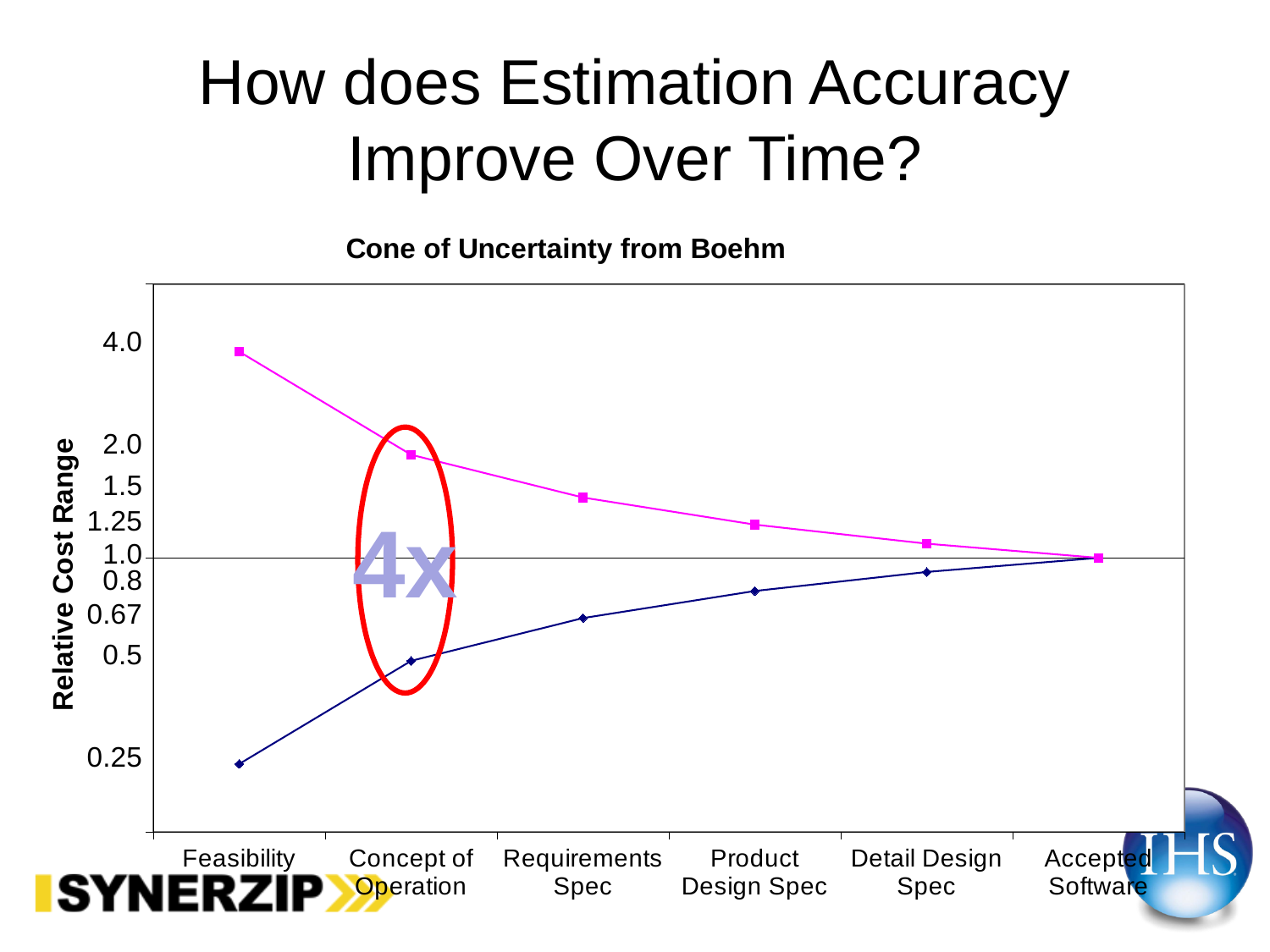
Does the upper (pink) line rise or fall from Feasibility to Accepted Software? fall Is the value of the upper (pink) line at Feasibility greater or less than 2.0? greater At which phase is the upper (pink) line highest? Feasibility Is the value of the upper (pink) line at Requirements Spec greater or less than 1.25? greater What is the title of the chart? Cone of Uncertainty from Boehm Is the value of the lower (navy) line at Feasibility greater or less than 0.5? less What kind of chart is shown on the slide? line chart At which phase is the lower (navy) line lowest? Feasibility How many project phases are shown along the x axis of the chart? 6 What is the label on the vertical axis of the chart? Relative Cost Range What value do both lines reach at Accepted Software? 1.0